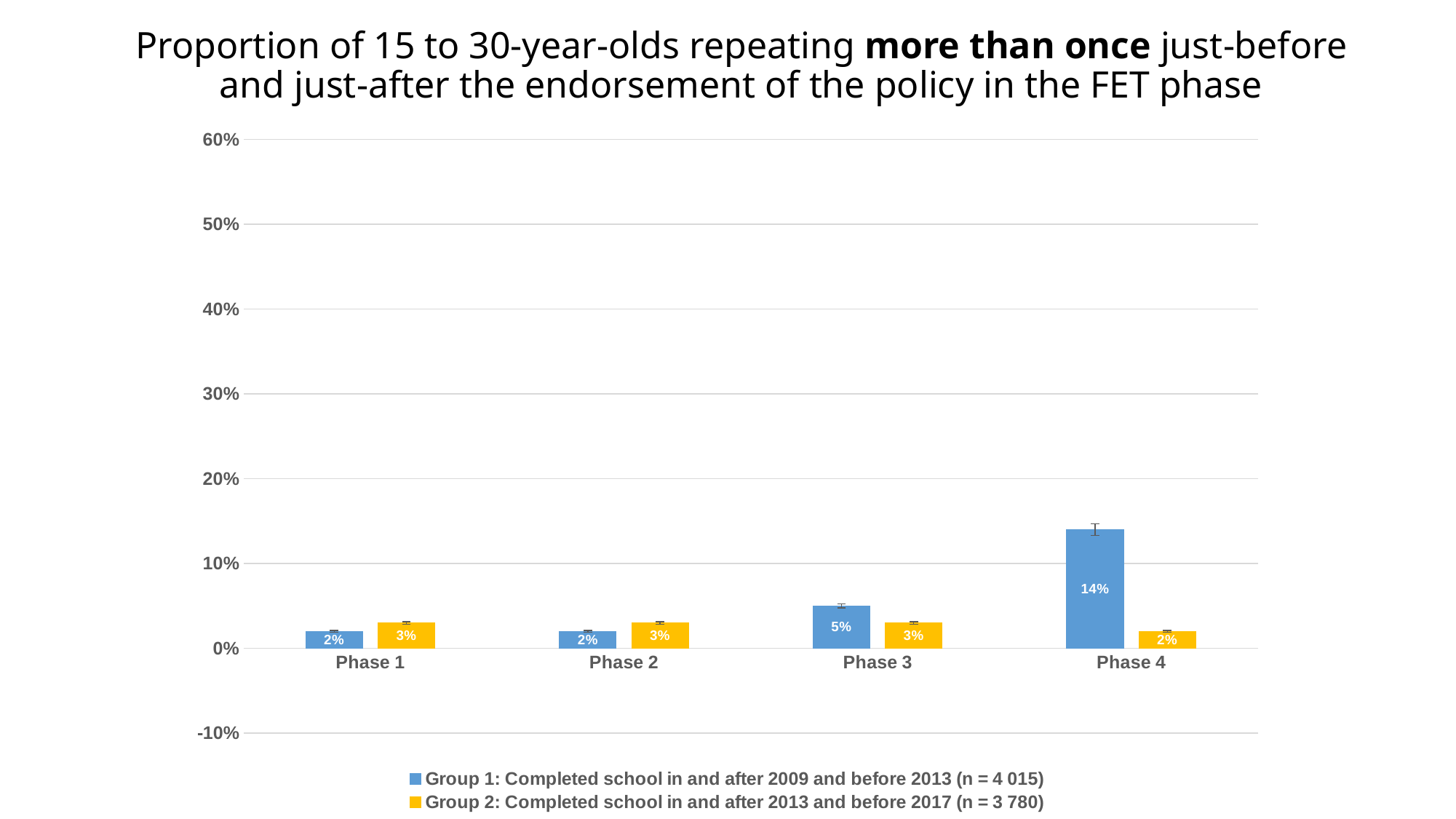
In which phase is the Group 2 value lowest? Phase 4 What is the value for Group 1 in Phase 1? 2% In which phase is the Group 1 value highest? Phase 4 What is the value for Group 2 in Phase 3? 3% In Phase 2, which group has the larger value? Group 2 How many series does the legend list? 2 How many phases are shown on the x axis? 4 What is the difference between Group 1 and Group 2 in Phase 3? 2% What kind of chart is shown on the slide? Bar chart Is the value for Group 1 in Phase 4 greater or less than 10%? greater What is the difference between Group 1 and Group 2 in Phase 4? 12% What is the value for Group 1 in Phase 4? 14%